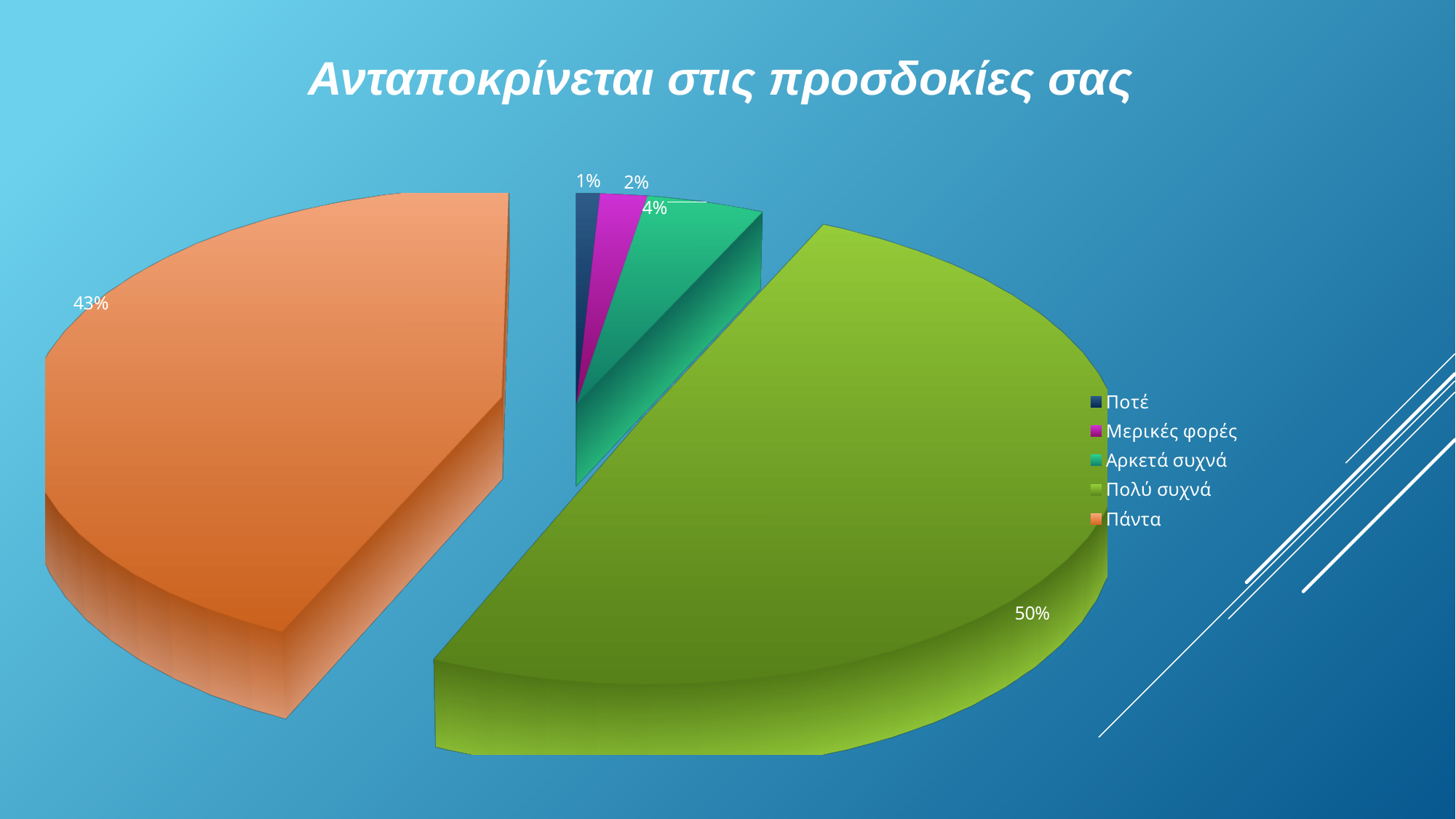
Which category has the smallest share of the pie? Ποτέ Which is larger, the share for Αρκετά συχνά or the share for Μερικές φορές? Αρκετά συχνά What percentage is shown for Ποτέ? 1% How many slices does the pie chart have? 5 What percentage is shown for Πολύ συχνά? 50% Which category has the largest share of the pie? Πολύ συχνά What is the difference between the shares of Πολύ συχνά and Πάντα? 7% What kind of chart is shown on the slide? pie chart What percentage is shown for Μερικές φορές? 2% What percentage is shown for Πάντα? 43% What percentage is shown for Αρκετά συχνά? 4% What is the title of the chart? Ανταποκρίνεται στις προσδοκίες σας